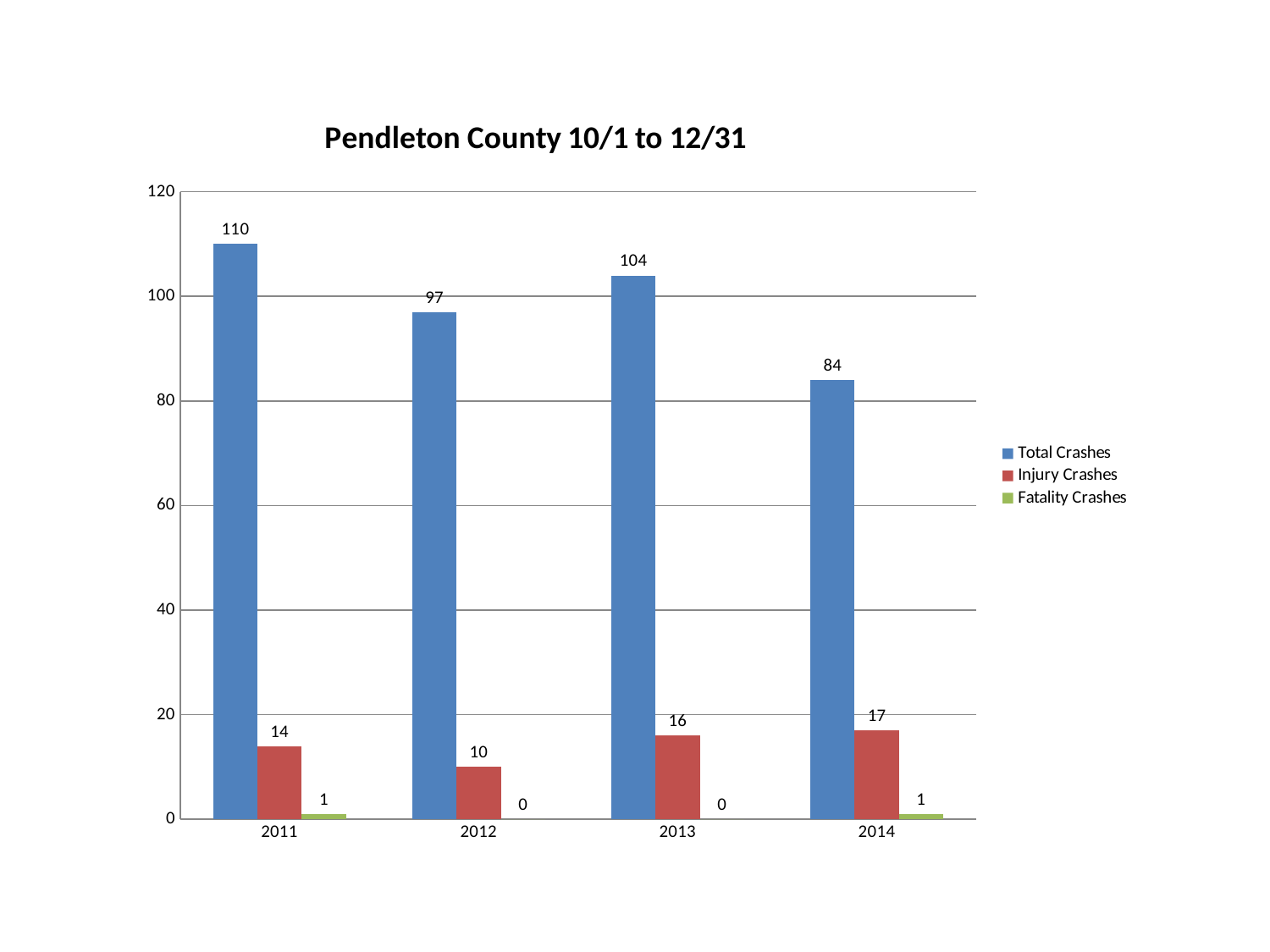
What kind of chart is shown? bar chart Which year has the lowest Injury Crashes? 2012 How many series does the legend list? 3 How many years are shown on the x axis? 4 What is the difference between Total Crashes in 2011 and 2014? 26 Which is larger, Total Crashes in 2012 or Total Crashes in 2013? 2013 Which year has the highest Total Crashes? 2011 What is the value for Injury Crashes in 2014? 17 What is the value for Total Crashes in 2011? 110 What is the title of the chart? Pendleton County 10/1 to 12/31 Is the value for Total Crashes in 2014 greater or less than 100? less What is the value for Fatality Crashes in 2012? 0